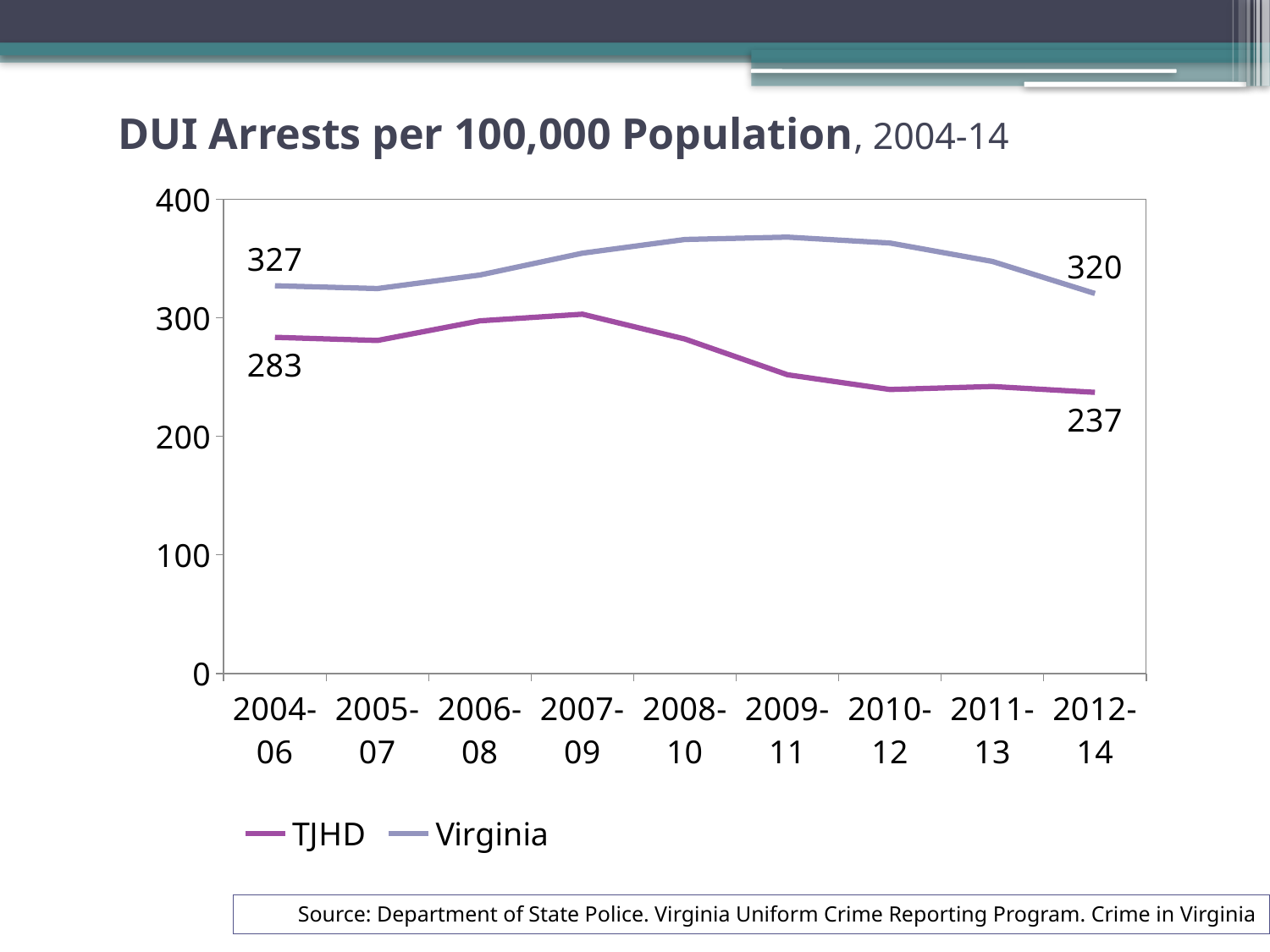
What is the Virginia value for 2012-14? 320 What is the Virginia value for 2004-06? 327 How many series does the legend list? 2 How many time periods are shown on the x axis? 9 What is the difference between the Virginia and TJHD values in 2012-14? 83 What kind of chart is shown on the slide? line chart Which series is higher in 2009-11, TJHD or Virginia? Virginia What is the TJHD value for 2004-06? 283 Does the TJHD line rise or fall from 2007-09 to 2012-14? fall Is the TJHD value for 2009-11 greater or less than 300? less By how much did the TJHD value change from 2004-06 to 2012-14? 46 What is the TJHD value for 2012-14? 237